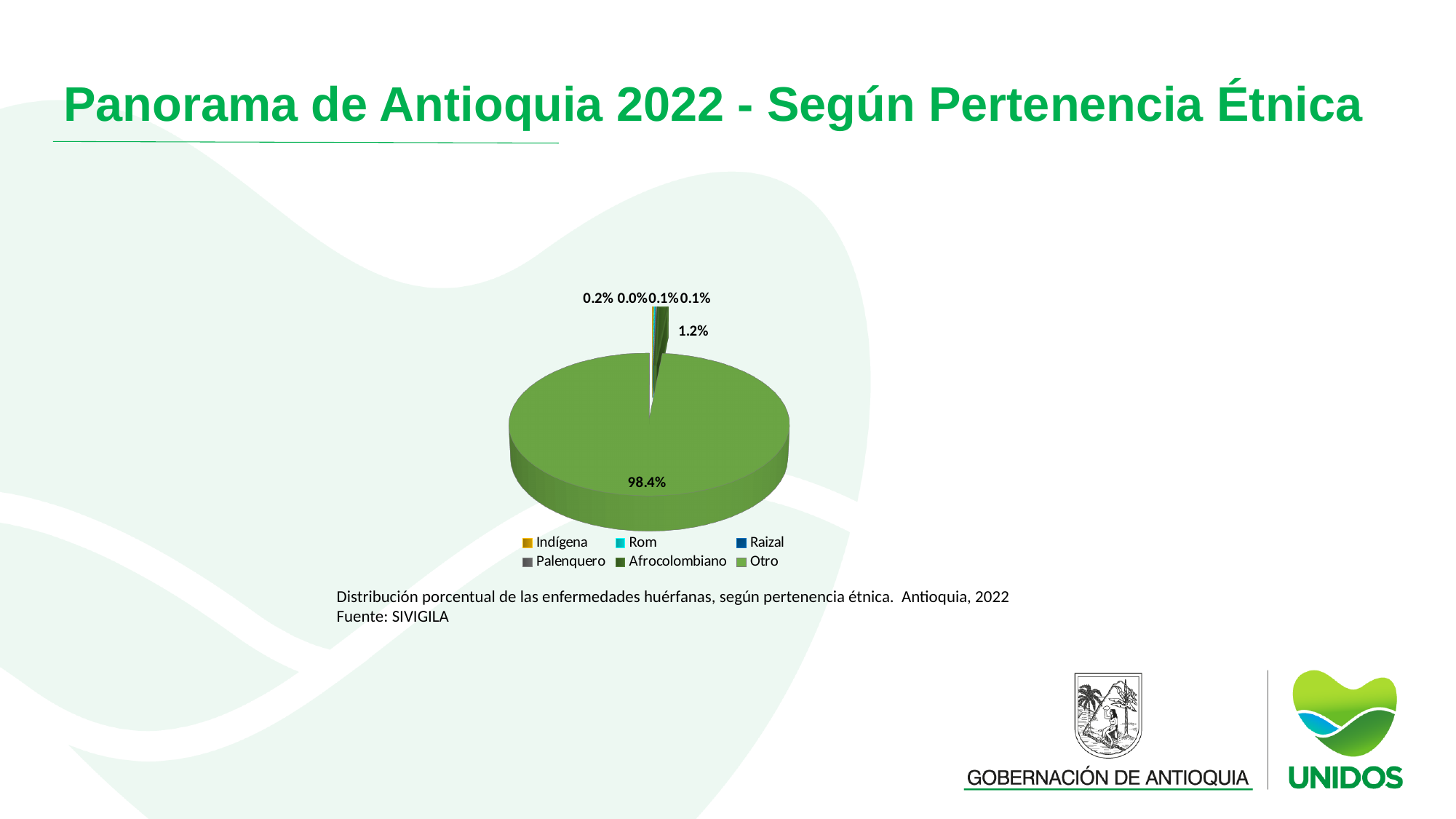
What is the title of the slide containing the pie chart? Panorama de Antioquia 2022 - Según Pertenencia Étnica According to the caption below the chart, what is the data source? SIVIGILA Is the share for Afrocolombiano greater or less than 5%? less Which is larger, the share for Otro or the share for Afrocolombiano? Otro Which category has the largest share of the pie chart? Otro What percentage share does the Otro category have in the pie chart? 98.4% Is the share for Otro greater or less than 90%? greater What percentage share does the Afrocolombiano category have in the pie chart? 1.2% What is the difference in percentage points between the Otro share (98.4%) and the Afrocolombiano share (1.2%)? 97.2 What kind of chart is shown on the slide? Pie chart How many categories does the legend of the pie chart list? 6